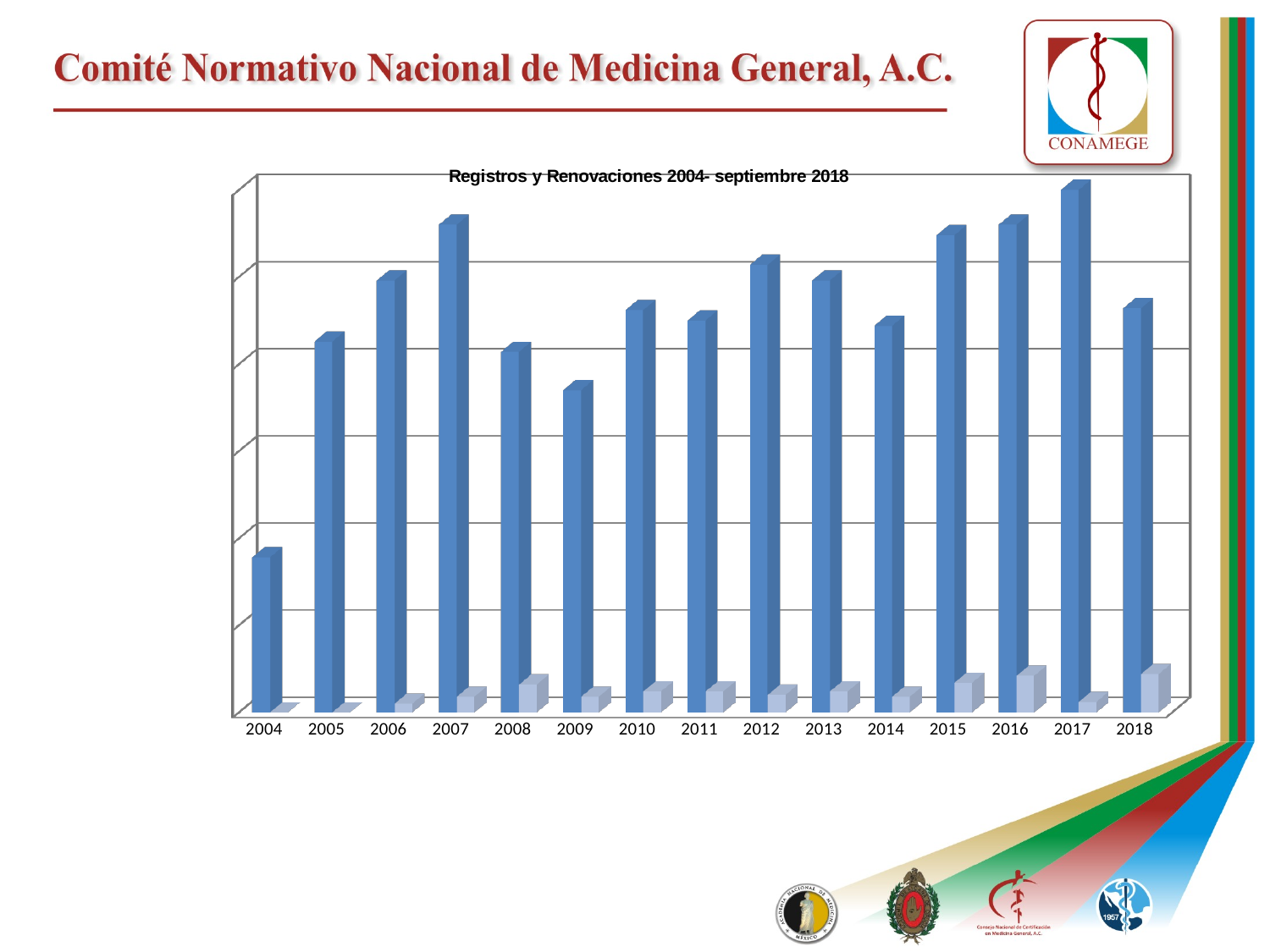
Which year has the taller dark blue bar, 2005 or 2006? 2006 How many years are shown on the x axis of the chart? 15 Which year has the shortest dark blue bar? 2004 Is the dark blue bar for 2007 taller or shorter than the dark blue bar for 2008? Taller Do the dark blue bars rise or fall from 2014 to 2017? Rise Which year has the taller dark blue bar, 2009 or 2010? 2010 What is the first year shown on the x axis of the chart? 2004 Do the dark blue bars rise or fall from 2004 to 2007? Rise What is the title of the chart? Registros y Renovaciones 2004- septiembre 2018 What kind of chart is shown on the slide? Bar chart Which year has the tallest dark blue bar? 2017